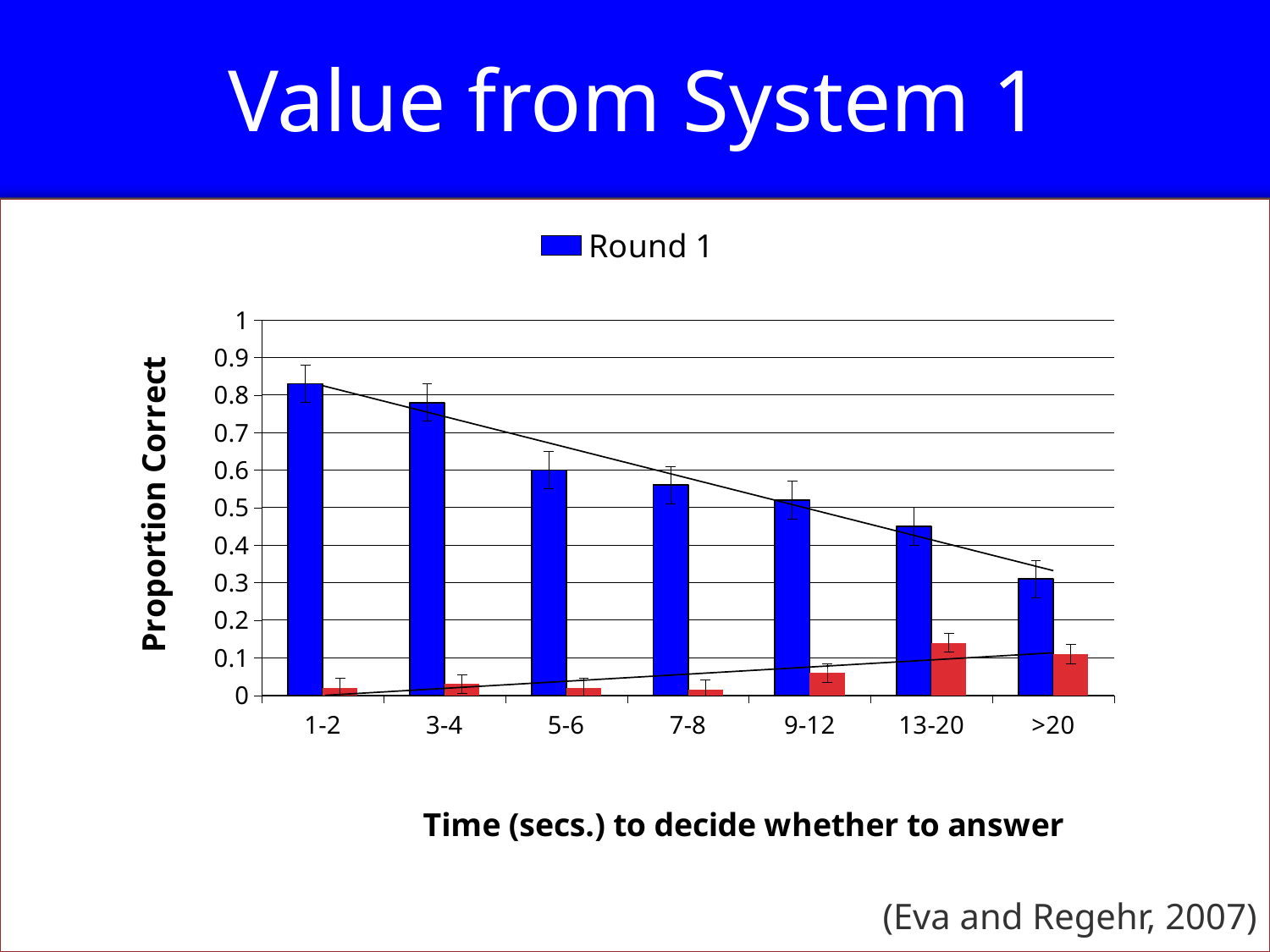
Is the Round 1 value for >20 greater or less than 0.4? less What is the title of the x axis? Time (secs.) to decide whether to answer What kind of chart is shown on the slide? bar chart How many time categories are shown on the x axis? 7 What is the title of the y axis? Proportion Correct Which time category has the highest Round 1 proportion correct? 1-2 How many series does the legend list? 1 Do the Round 1 values rise or fall as time to decide increases along the x axis? fall Is the Round 1 value for 13-20 greater or less than 0.5? less Is the Round 1 value for 1-2 greater or less than 0.8? greater Which has a larger Round 1 value, 3-4 or 7-8? 3-4 Which time category has the lowest Round 1 proportion correct? >20